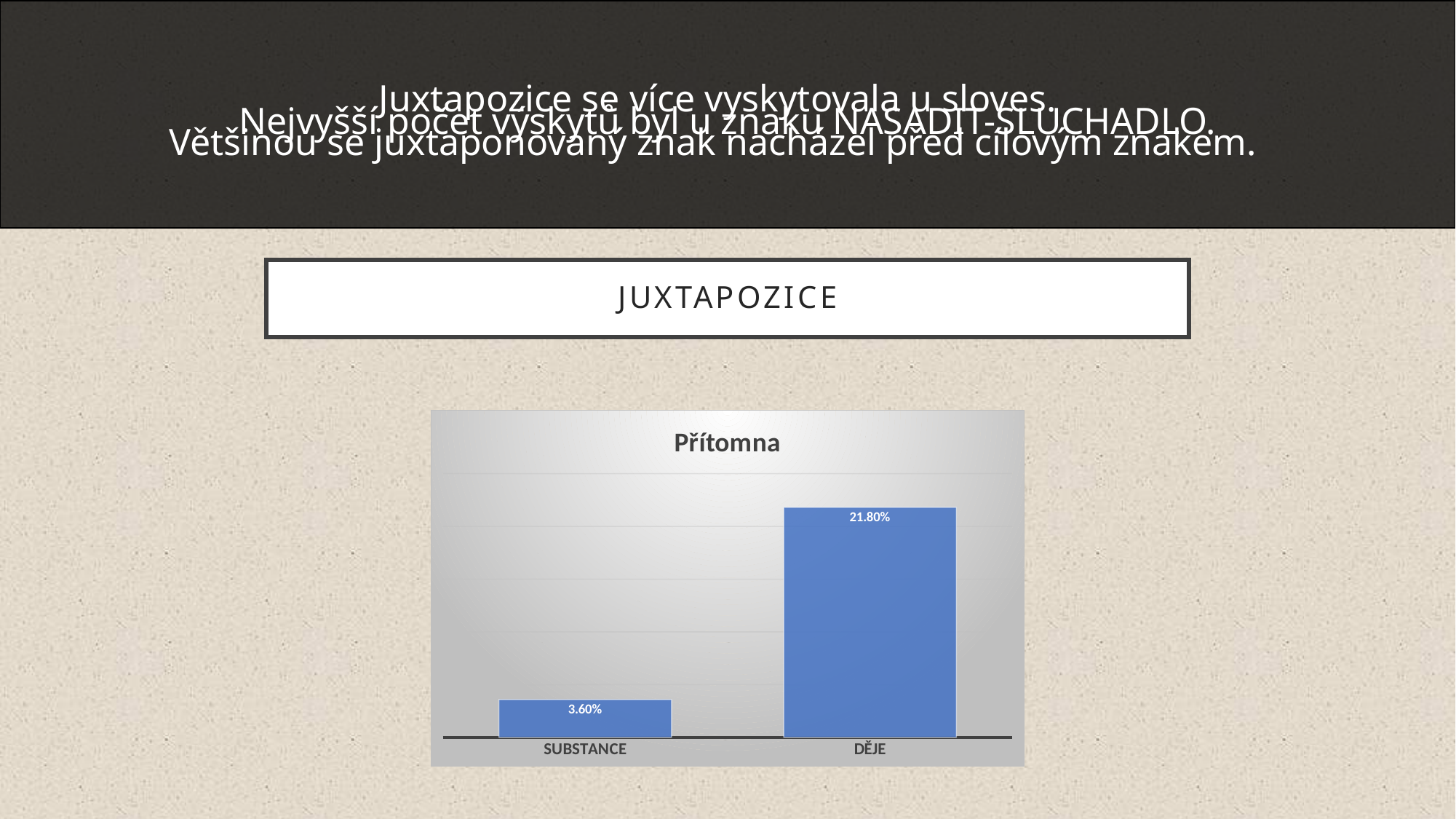
What is the difference between the values for DĚJE and SUBSTANCE? 18.20% What is the value for DĚJE? 21.80% How many categories are shown in the chart? 2 What is the title of the chart? Přítomna Which category has the lowest value? SUBSTANCE What is the value for SUBSTANCE? 3.60% Which category has the highest value? DĚJE What colour are the bars in the chart? blue Which is larger, the value for SUBSTANCE or the value for DĚJE? DĚJE What kind of chart is shown on the slide? bar chart